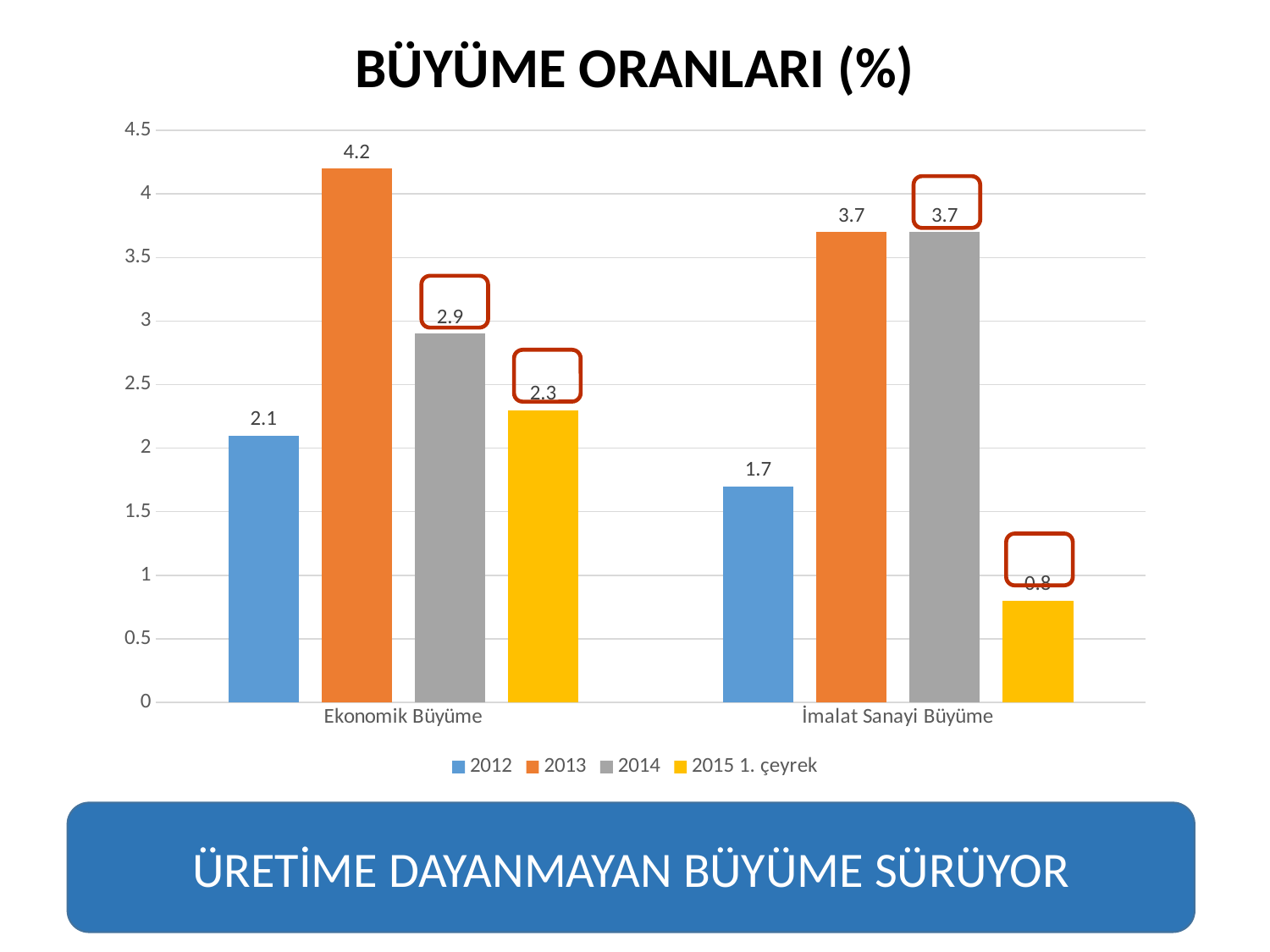
What kind of chart is shown on the slide? Bar chart What is the difference between the 2014 and 2015 1. çeyrek values for İmalat Sanayi Büyüme? 2.9 What is the difference between the 2013 and 2014 values for Ekonomik Büyüme? 1.3 What is the 2014 value for Ekonomik Büyüme? 2.9 Which series has the highest value for Ekonomik Büyüme? 2013 What is the title of the chart? BÜYÜME ORANLARI (%) What is the 2012 value for İmalat Sanayi Büyüme? 1.7 Which series has the lowest value for İmalat Sanayi Büyüme? 2015 1. çeyrek Which is larger: the 2012 value for Ekonomik Büyüme or the 2012 value for İmalat Sanayi Büyüme? Ekonomik Büyüme What is the 2015 1. çeyrek value for İmalat Sanayi Büyüme? 0.8 What is the 2013 value for Ekonomik Büyüme? 4.2 How many series does the legend list? 4